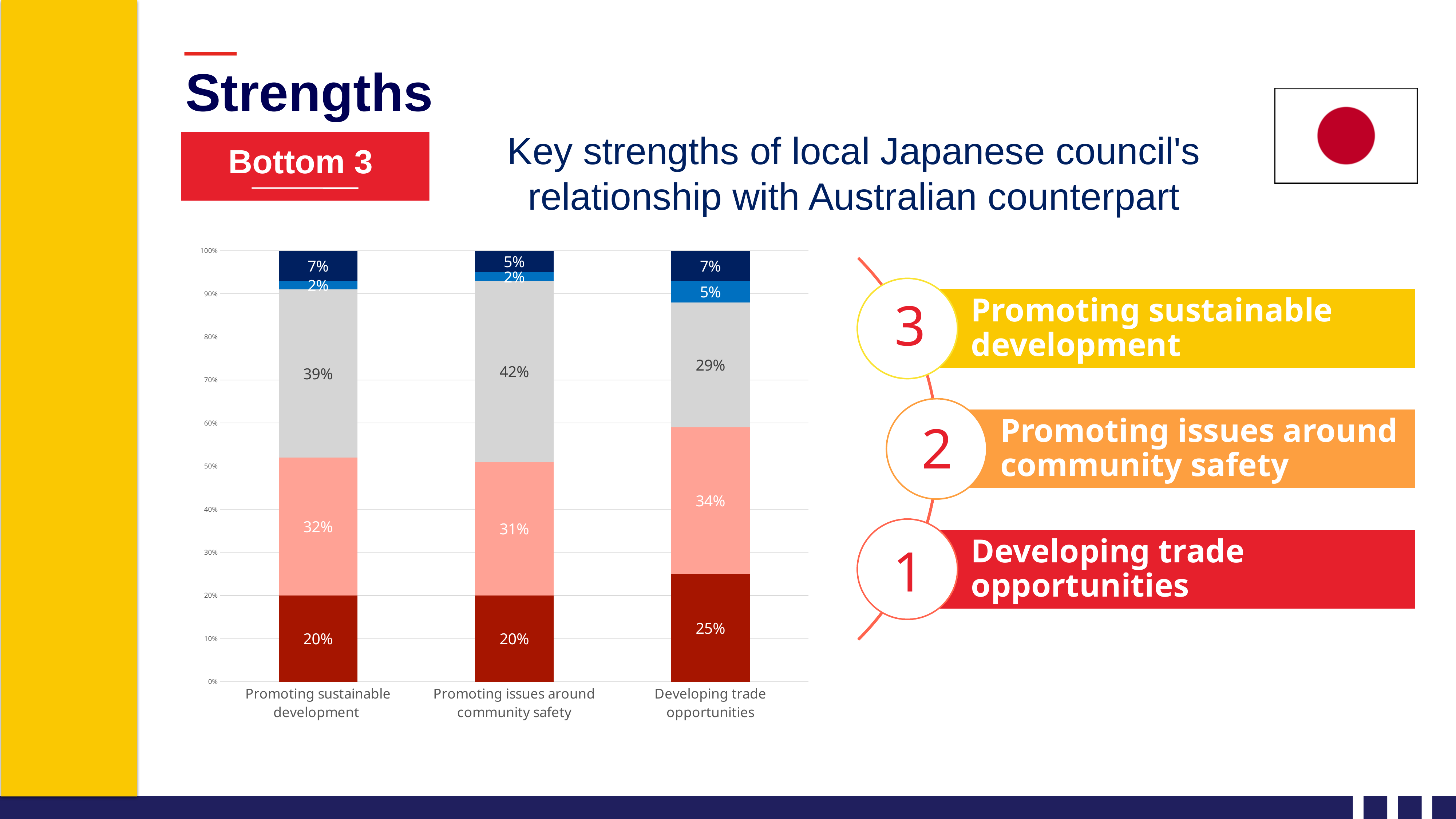
What is the value of the dark navy top segment for Promoting issues around community safety? 5% What is the value of the grey segment for Promoting issues around community safety? 42% Which category has the largest grey segment? Promoting issues around community safety Which is larger: the light pink segment for Developing trade opportunities or the light pink segment for Promoting issues around community safety? Developing trade opportunities What is the difference between the grey segment values for Promoting issues around community safety and Developing trade opportunities? 13% What is the title of the chart? Key strengths of local Japanese council's relationship with Australian counterpart What type of chart is shown on the slide? Stacked bar chart What is the total of the stacked bar for Promoting sustainable development? 100% Which category has the smallest grey segment? Developing trade opportunities How many categories are shown on the x axis of the chart? 3 What is the value of the light pink segment for Promoting sustainable development? 32% What is the value of the dark red bottom segment for Developing trade opportunities? 25%